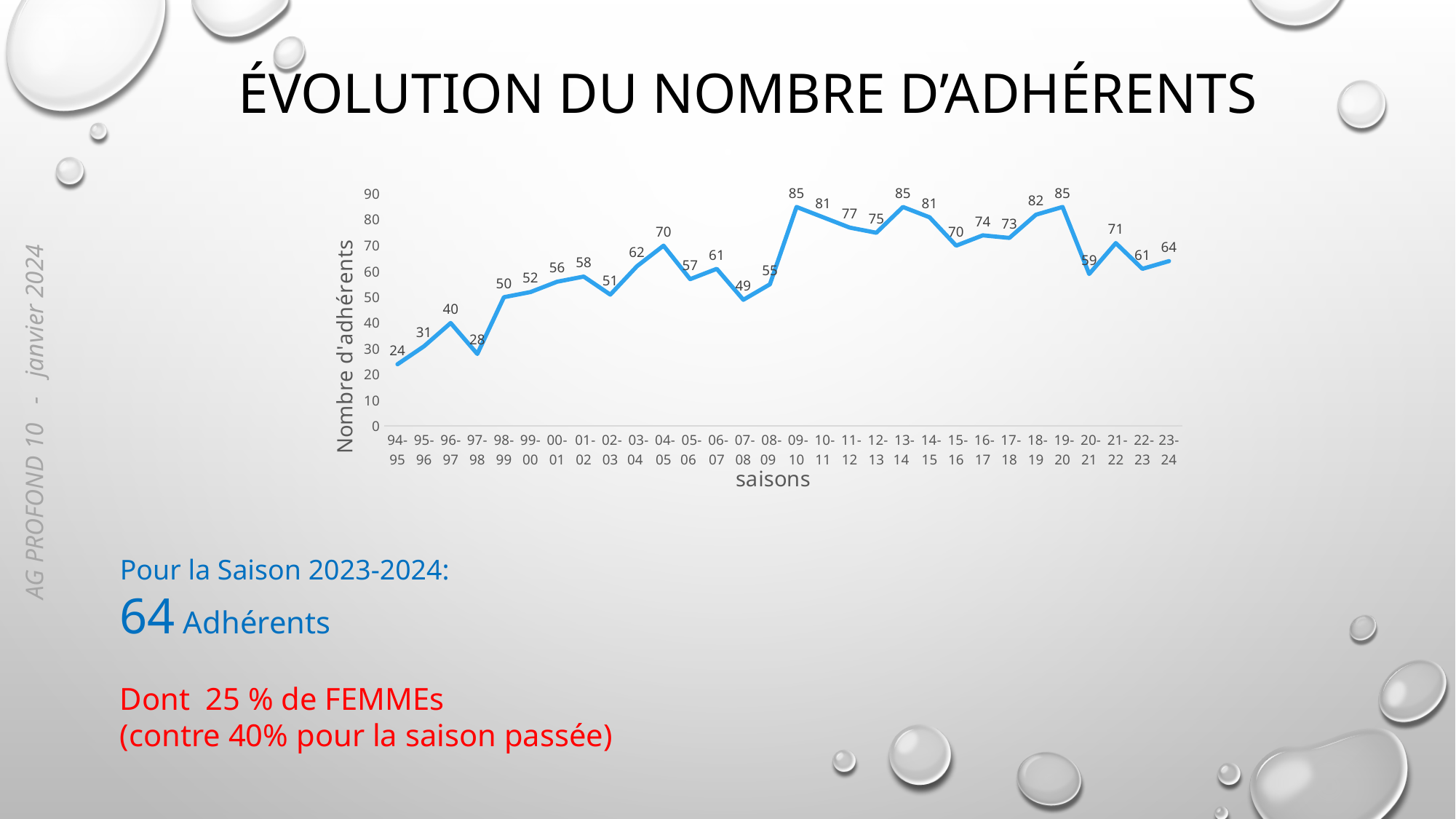
What is the difference in adhérents between the 19-20 season and the 20-21 season? 26 What is the number of adhérents for the 23-24 season? 64 Which season has more adhérents, 04-05 or 07-08? 04-05 What is the label of the vertical axis? Nombre d'adhérents What is the number of adhérents for the 97-98 season? 28 What is the number of adhérents for the 09-10 season? 85 Which season has the lowest number of adhérents? 94-95 Do the values rise or fall from the 94-95 season to the 96-97 season? rise Is the value for the 21-22 season greater or less than 60? greater What kind of chart is shown on the slide? line chart What is the highest number of adhérents shown on the chart? 85 How many seasons are plotted on the chart? 30